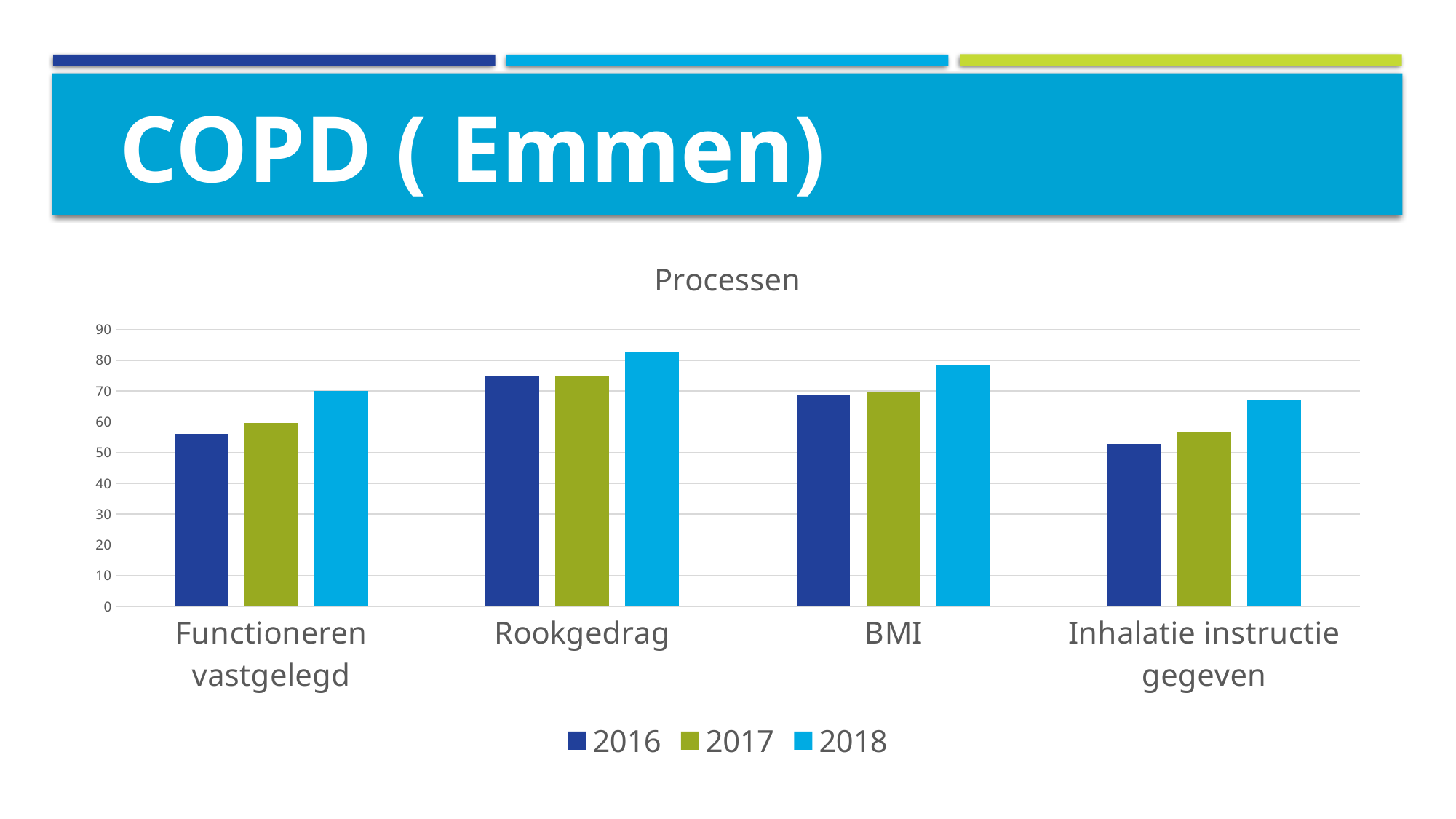
What is the title of the chart? Processen Which legend entry is shown in light blue? 2018 Is the value for Inhalatie instructie gegeven in 2018 greater or less than 60? greater Is the value for Functioneren vastgelegd in 2016 greater or less than 60? less What type of chart is shown on the slide? bar chart For BMI, do the values rise or fall from 2016 to 2018? rise Which category has the highest value for 2018? Rookgedrag How many categories are shown on the x axis? 4 How many series does the legend list? 3 Which category has the lowest value for 2016? Inhalatie instructie gegeven Which is larger for 2018: Functioneren vastgelegd or BMI? BMI Is the value for Rookgedrag in 2018 greater or less than 80? greater